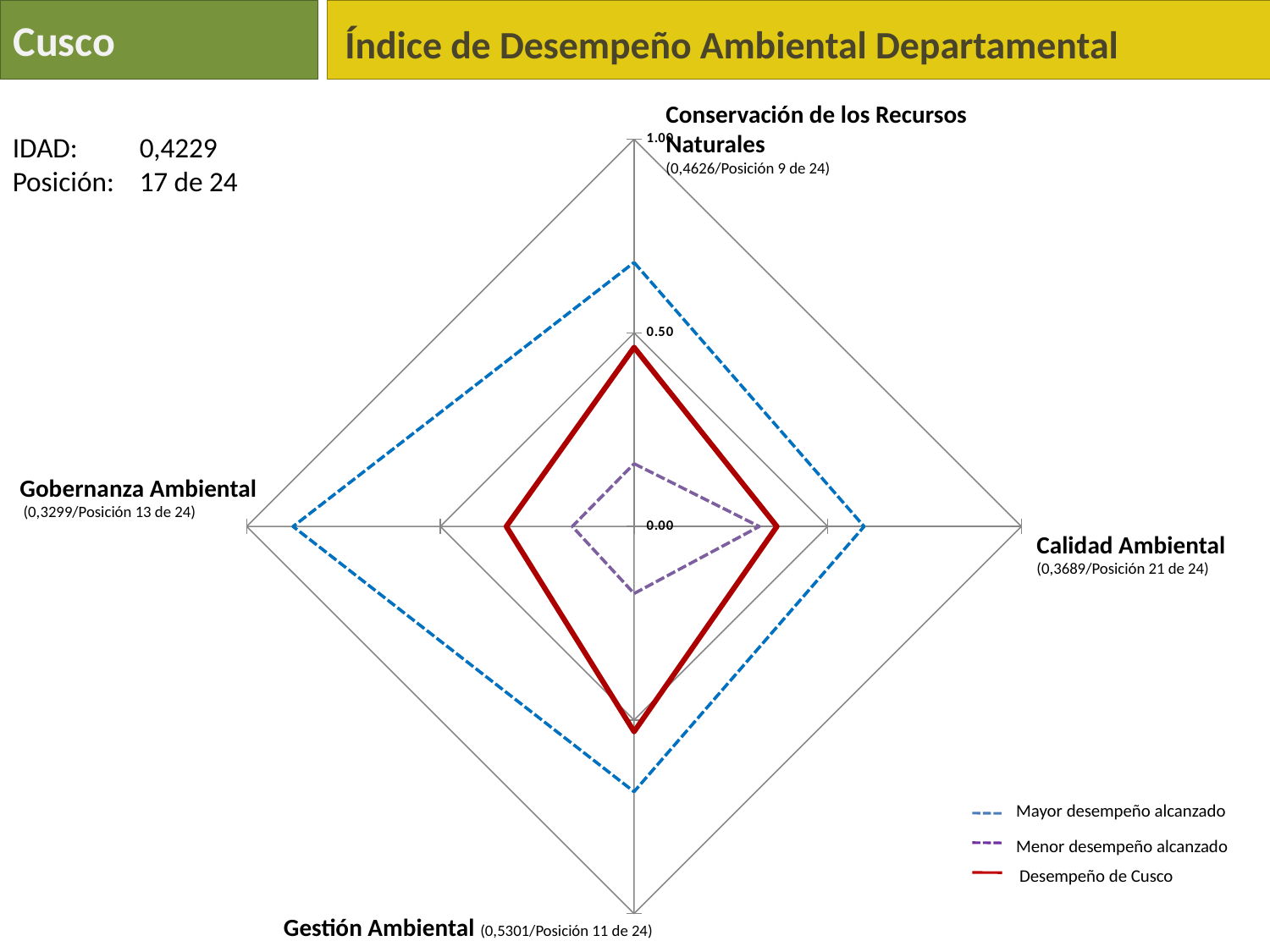
What kind of chart is shown on the slide? Radar chart How many series does the legend list? 3 What is Cusco's value for Conservación de los Recursos Naturales? 0,4626 What is Cusco's value for Gestión Ambiental? 0,5301 What is Cusco's value for Gobernanza Ambiental? 0,3299 Is Cusco's value for Gestión Ambiental greater or less than 0.50? greater What is Cusco's value for Calidad Ambiental? 0,3689 What is the difference between Cusco's Gestión Ambiental value and its Gobernanza Ambiental value? 0,2002 In which category does Cusco have its lowest value? Gobernanza Ambiental How many axes (categories) does the radar chart have? 4 In which category does Cusco have its highest value? Gestión Ambiental Which series is drawn as a solid red line in the legend? Desempeño de Cusco